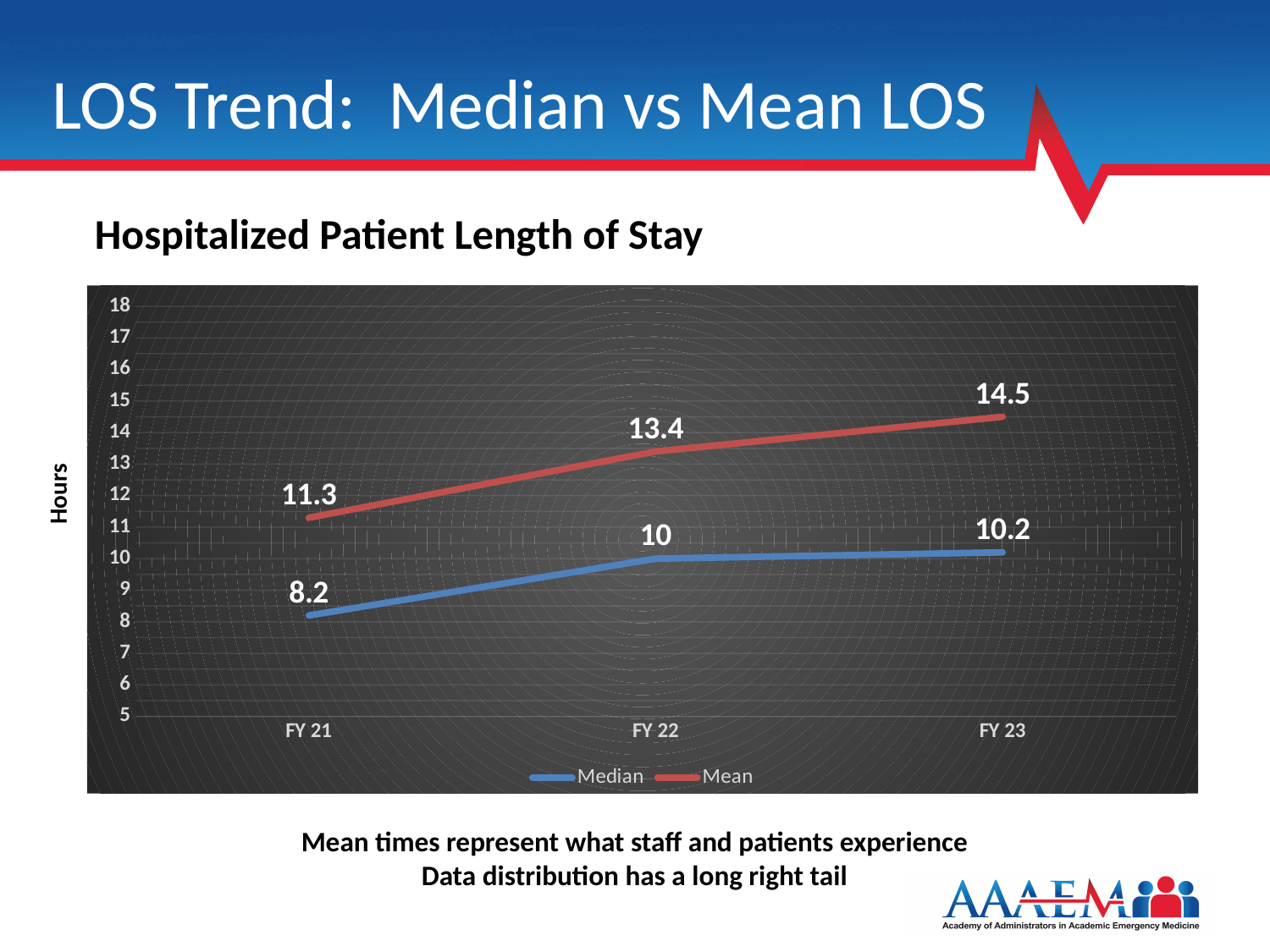
Which is larger in FY 22, the Mean or the Median length of stay? Mean What is the Median length of stay for FY 23? 10.2 By how much did the Mean length of stay increase from FY 21 to FY 23? 3.2 How many series does the legend list? 2 What is the Mean length of stay for FY 23? 14.5 What is the difference between the Mean and Median length of stay in FY 21? 3.1 What is the Median length of stay for FY 21? 8.2 In which fiscal year is the Median length of stay lowest? FY 21 What is the Mean length of stay for FY 22? 13.4 What kind of chart is shown on the slide? Line chart How many fiscal years are plotted on the x axis? 3 In which fiscal year is the Mean length of stay highest? FY 23